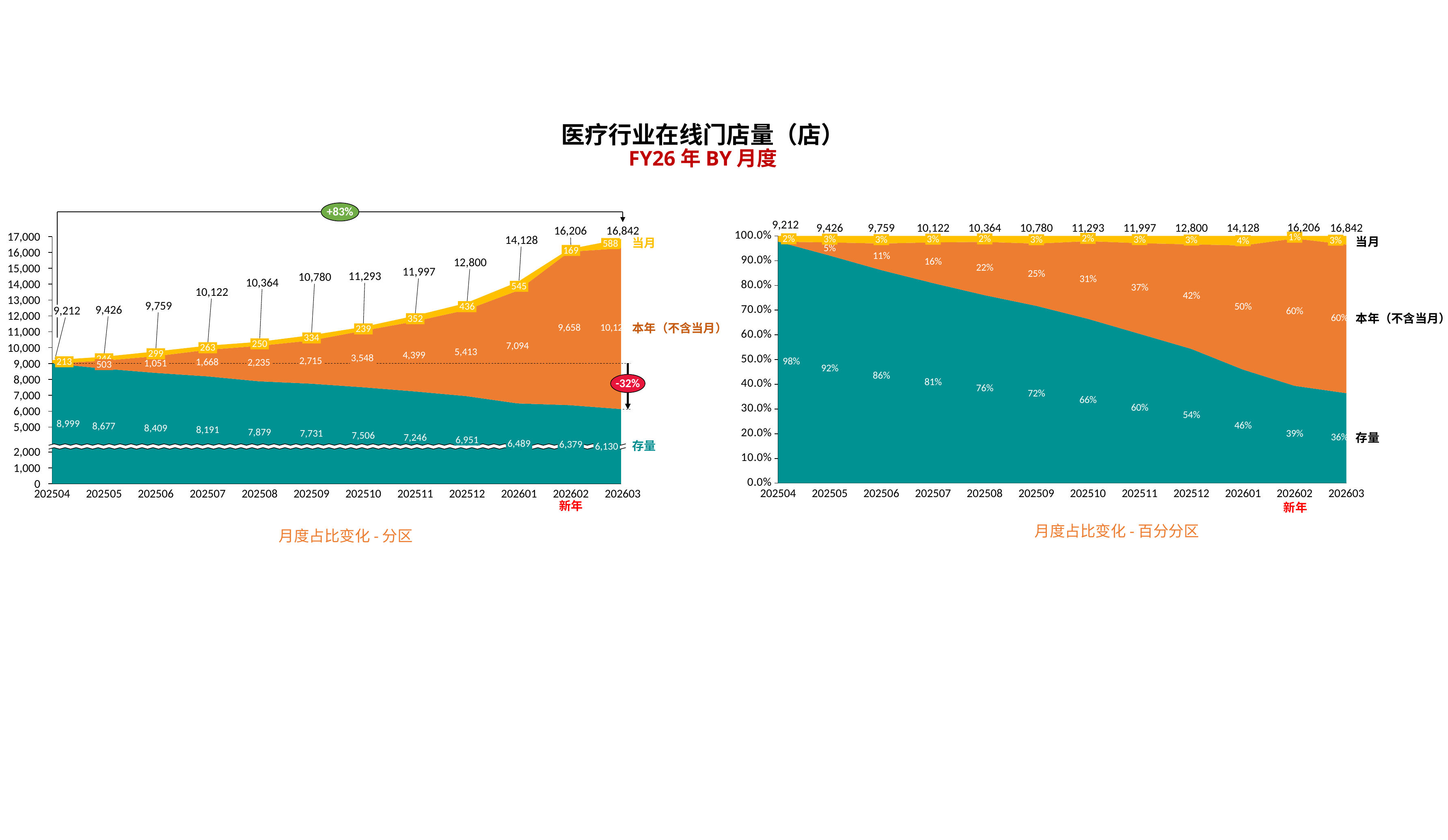
In the right chart (月度占比变化 - 百分分区), which is larger for 202511: the 存量 share or the 本年（不含当月） share? 存量 In the left chart (月度占比变化 - 分区), what is the 当月 value for 202602? 169 In the left chart (月度占比变化 - 分区), what is the 存量 value for 202504? 8,999 In the left chart (月度占比变化 - 分区), does the 存量 series rise or fall from 202504 to 202603? fall What kind of chart is the right chart (月度占比变化 - 百分分区)? stacked area chart In the right chart (月度占比变化 - 百分分区), what is the 存量 share for 202601? 46% In the left chart (月度占比变化 - 分区), which month has the highest 当月 value? 202603 In the left chart (月度占比变化 - 分区), what is the total value labelled for 202603? 16,842 In the right chart (月度占比变化 - 百分分区), what is the 本年（不含当月） share for 202510? 31% In the left chart (月度占比变化 - 分区), what is the difference between the 存量 values for 202504 and 202603? 2,869 In the left chart (月度占比变化 - 分区), how many months are shown on the x axis? 12 In the left chart (月度占比变化 - 分区), what is the 本年（不含当月） value for 202512? 5,413